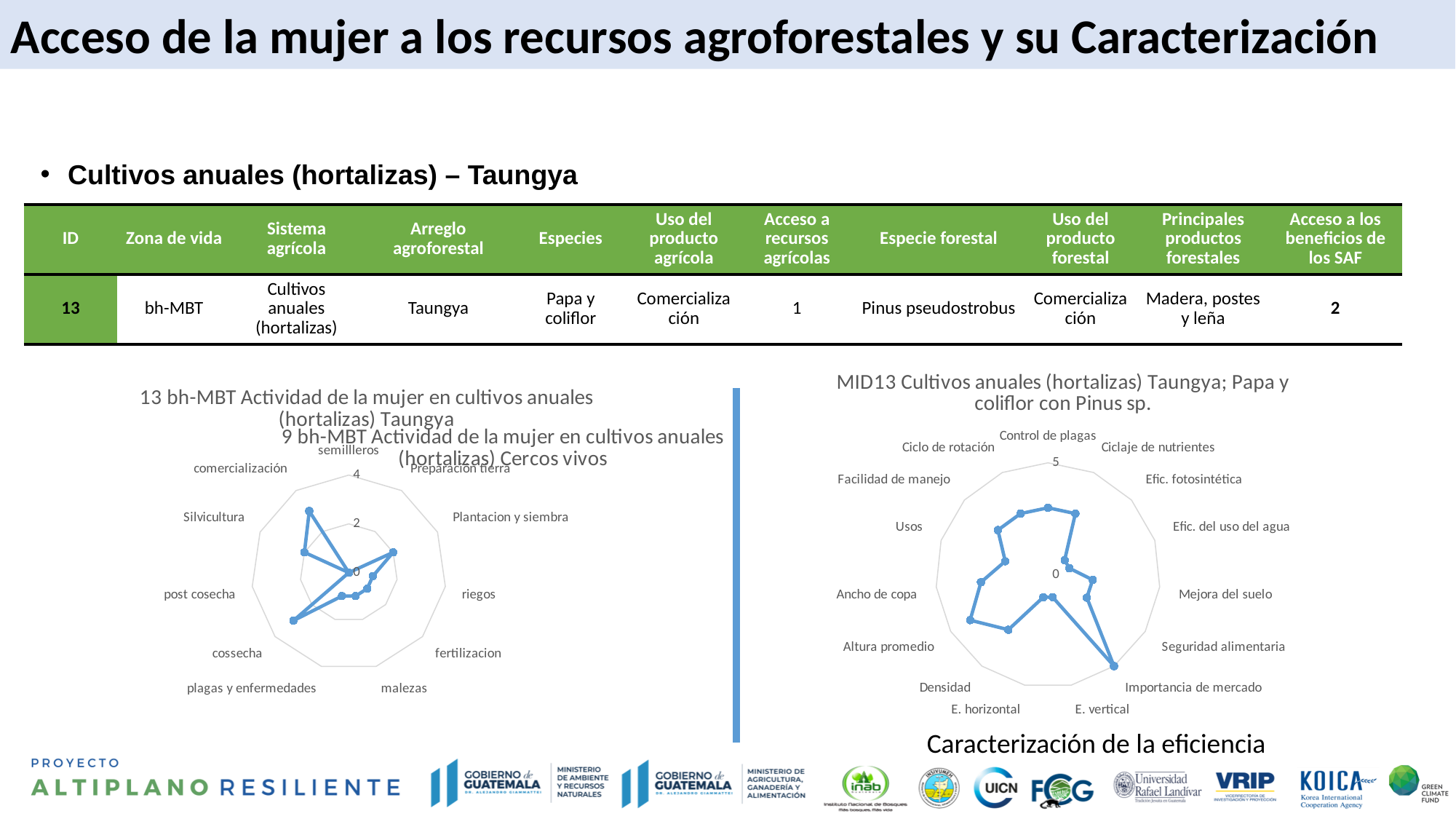
How many categories (axes) does the left radar chart on women's activity in Taungya have? 11 In the right radar chart 'MID13 Cultivos anuales (hortalizas) Taungya', which has the larger value, 'Importancia de mercado' or 'Control de plagas'? Importancia de mercado In the left radar chart on women's activity in Taungya, is the value for 'fertilizacion' greater or less than 2? less What type of chart is the right chart titled 'MID13 Cultivos anuales (hortalizas) Taungya; Papa y coliflor con Pinus sp.'? Radar chart In the right radar chart 'MID13 Cultivos anuales (hortalizas) Taungya', which category has the highest value? Importancia de mercado In the left radar chart on women's activity in Taungya, which has the larger value, 'cossecha' or 'fertilizacion'? cossecha In the left radar chart on women's activity in Taungya, is the value for 'riegos' greater or less than 2? less How many categories (axes) does the right radar chart 'MID13 Cultivos anuales (hortalizas) Taungya' have? 15 In the left radar chart on women's activity in Taungya, is the value for 'semilleros' greater or less than 2? less What type of chart is the left chart titled '13 bh-MBT Actividad de la mujer en cultivos anuales (hortalizas) Taungya'? Radar chart In the right radar chart 'MID13 Cultivos anuales (hortalizas) Taungya', which has the larger value, 'Altura promedio' or 'Mejora del suelo'? Altura promedio What is the highest axis tick value shown on the right radar chart 'MID13 Cultivos anuales (hortalizas) Taungya'? 5